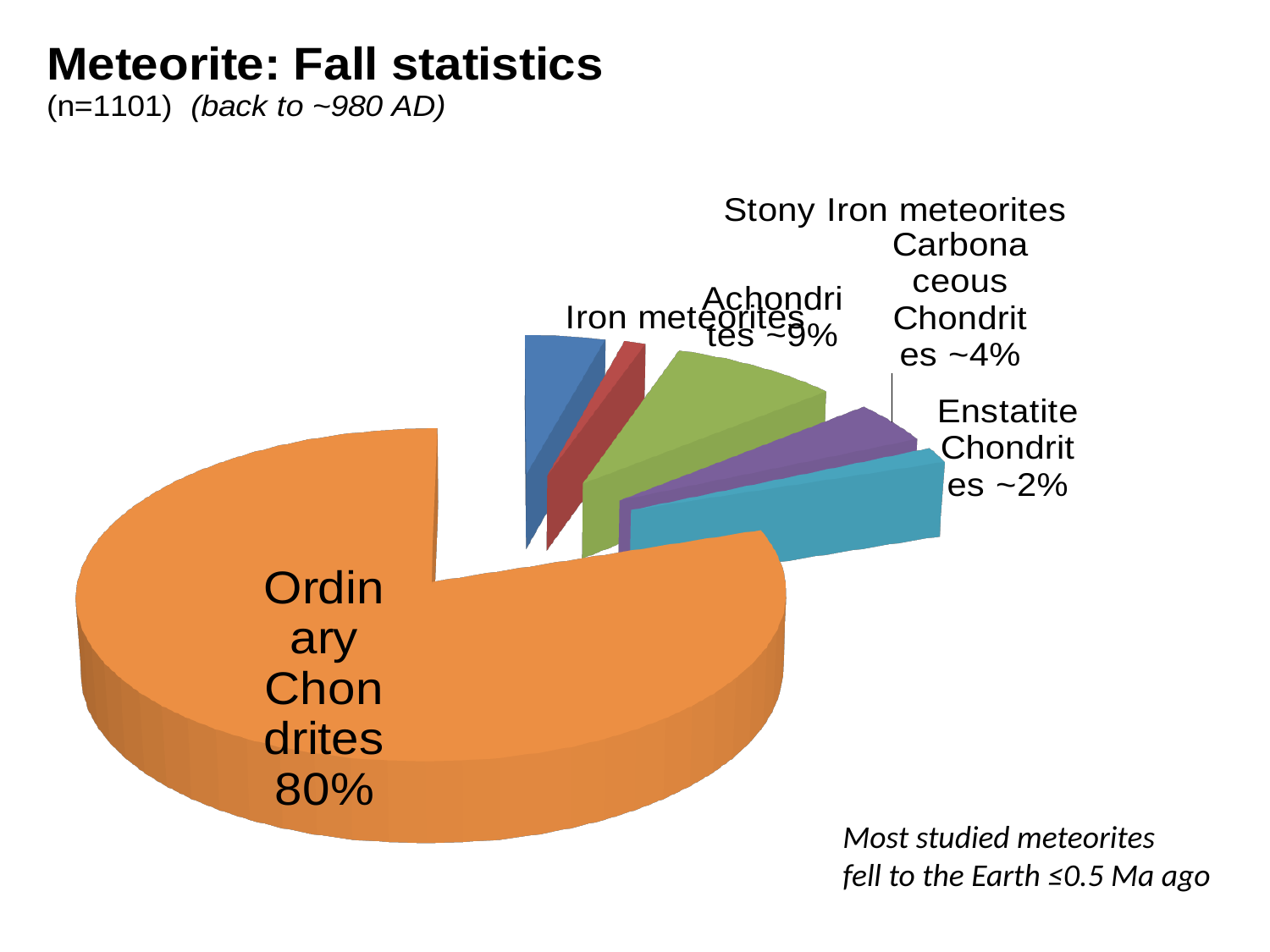
What share of the pie do Ordinary Chondrites account for? 80% What value is shown for Enstatite Chondrites? ~2% Which is larger, the slice for Ordinary Chondrites or the slice for Carbonaceous Chondrites? Ordinary Chondrites Which is larger, the slice for Achondrites or the slice for Enstatite Chondrites? Achondrites What colour is the Ordinary Chondrites slice? orange Which category has the largest slice of the pie? Ordinary Chondrites What kind of chart is shown on the slide? pie chart What is the title of the slide containing the chart? Meteorite: Fall statistics What value is shown for Carbonaceous Chondrites? ~4% What value is shown for Achondrites? ~9% How many slices does the pie chart have? 6